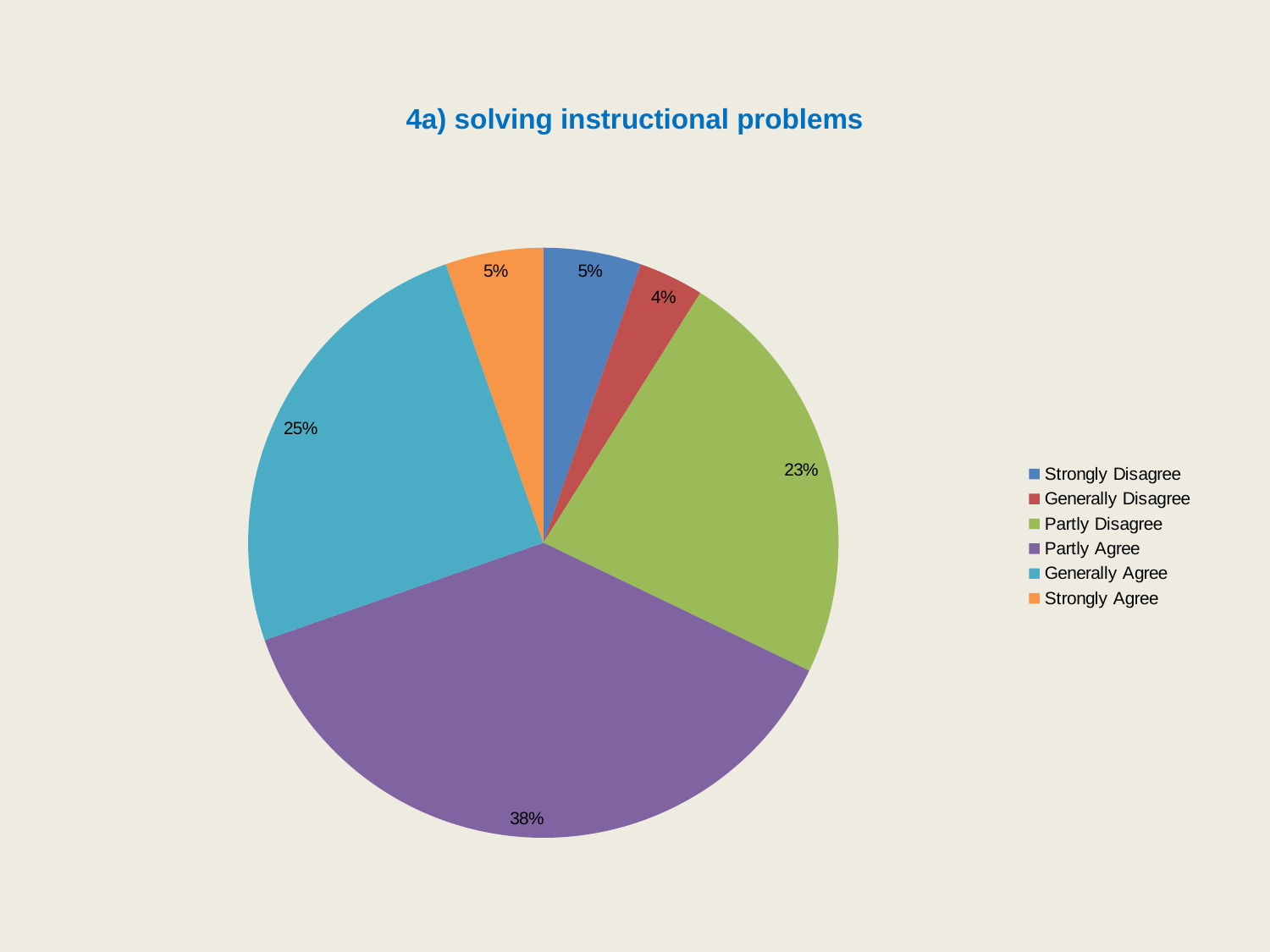
What type of chart is shown on the slide? pie chart How many categories does the legend list? 6 What share of the pie is Generally Disagree? 4% What is the difference in percentage points between Partly Agree and Generally Agree? 13 What is the title of the chart? 4a) solving instructional problems What share of the pie is Partly Agree? 38% Which is larger, the share for Partly Disagree or the share for Generally Agree? Generally Agree What share of the pie is Partly Disagree? 23% Which category has the largest slice of the pie? Partly Agree Which category has the smallest slice of the pie? Generally Disagree